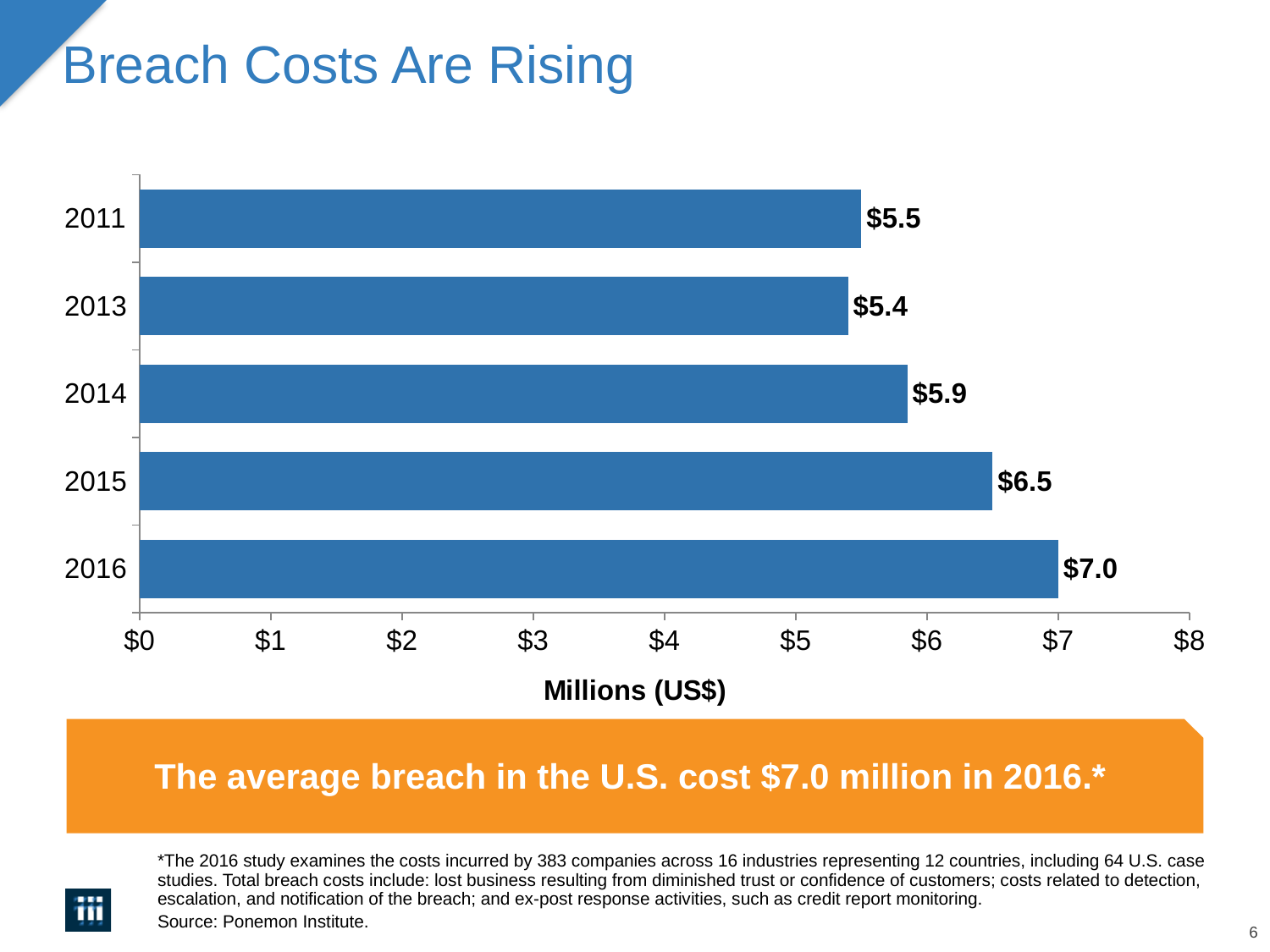
What is the value for 2016? $7.0 What is the difference between the values for 2016 and 2011? $1.5 Is the value for 2015 greater or less than $6? greater What is the value for 2013? $5.4 What is the x-axis label of the chart? Millions (US$) Which year has the highest value? 2016 Which year has the lowest value? 2013 Which is larger, the value for 2015 or the value for 2014? 2015 What is the value for 2014? $5.9 How many years are shown in the chart? 5 What is the difference between the values for 2015 and 2014? $0.6 What kind of chart is shown on the slide? bar chart